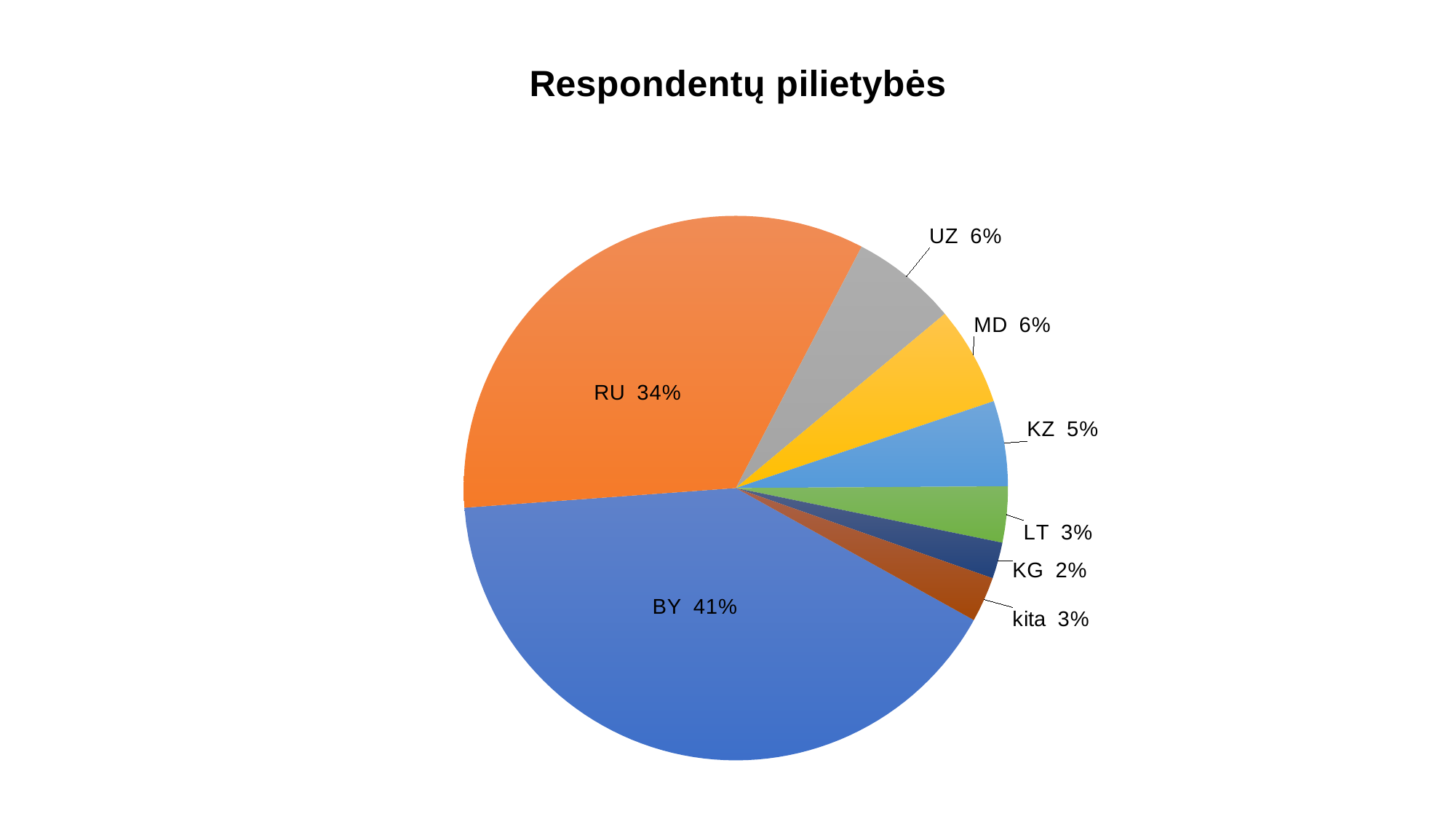
What is the value shown for KZ? 5% What share of respondents hold BY citizenship? 41% What colour is the RU slice? Orange How many slices does the pie chart have? 8 What is the difference in percentage points between BY and RU? 7 Which citizenship has the smallest slice of the pie? KG Which is larger, the share for KZ or the share for LT? KZ What kind of chart is shown on the slide? Pie chart What is the title of the chart? Respondentų pilietybės What is the value shown for KG? 2% What share of respondents hold RU citizenship? 34% Which citizenship has the largest slice of the pie? BY